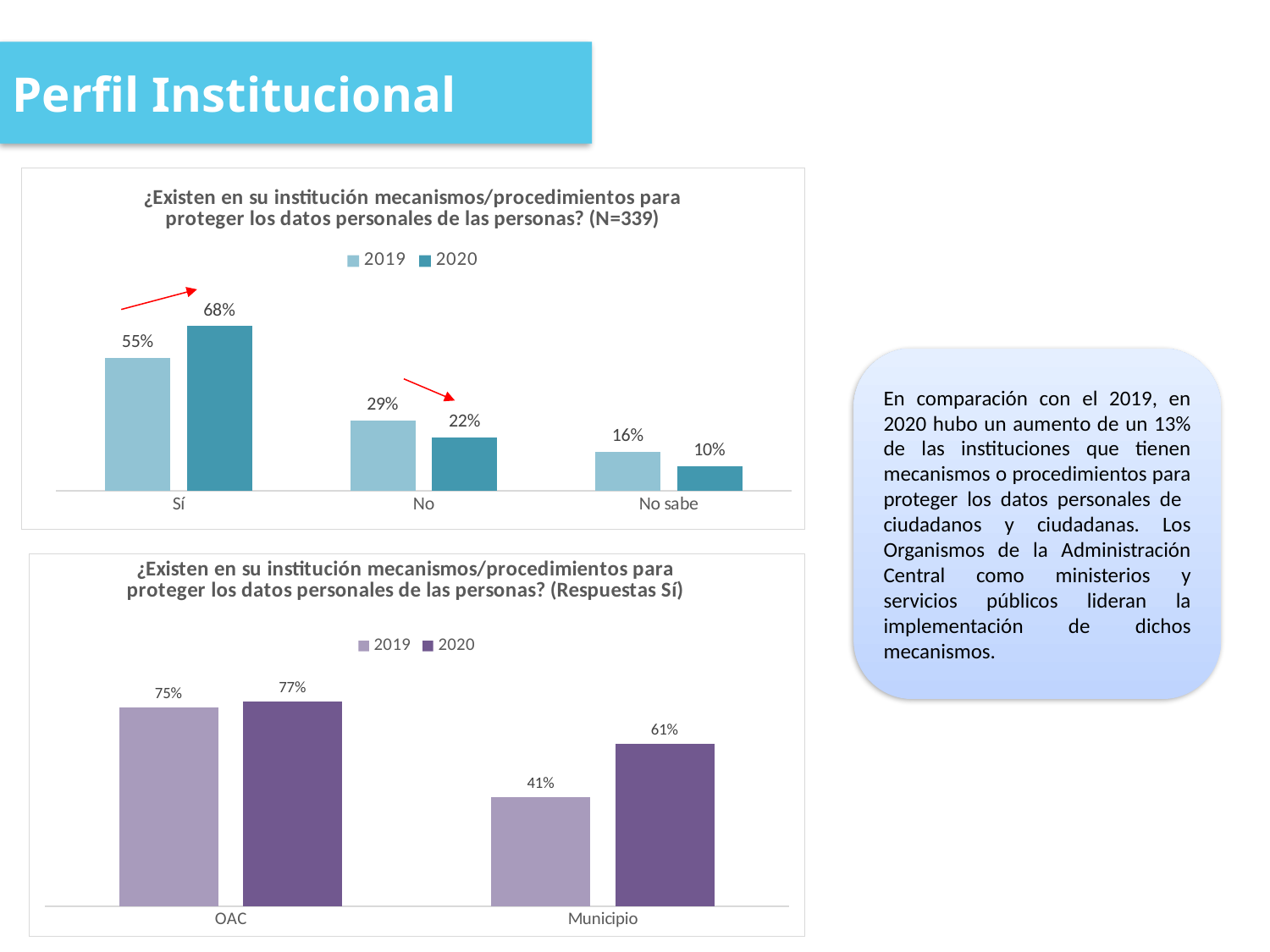
In the top chart (N=339), what is the 2019 value for 'No'? 29% In the bottom chart (Respuestas Sí), what is the 2020 value for 'OAC'? 77% In the top chart (N=339), how many categories are shown on the x axis? 3 In the top chart (N=339), how many series does the legend list? 2 In the bottom chart (Respuestas Sí), which is larger: the 2020 value for 'OAC' or the 2020 value for 'Municipio'? OAC In the top chart (N=339), what is the 2020 value for 'Sí'? 68% What kind of chart is the bottom chart (Respuestas Sí)? Bar chart In the top chart (N=339), which category has the lowest 2020 value? No sabe In the top chart (N=339), what is the 2020 value for 'No sabe'? 10% In the bottom chart (Respuestas Sí), what is the difference between the 2020 and 2019 values for 'Municipio'? 20% In the bottom chart (Respuestas Sí), what is the 2019 value for 'Municipio'? 41% In the top chart (N=339), what is the difference between the 2020 and 2019 values for 'Sí'? 13%